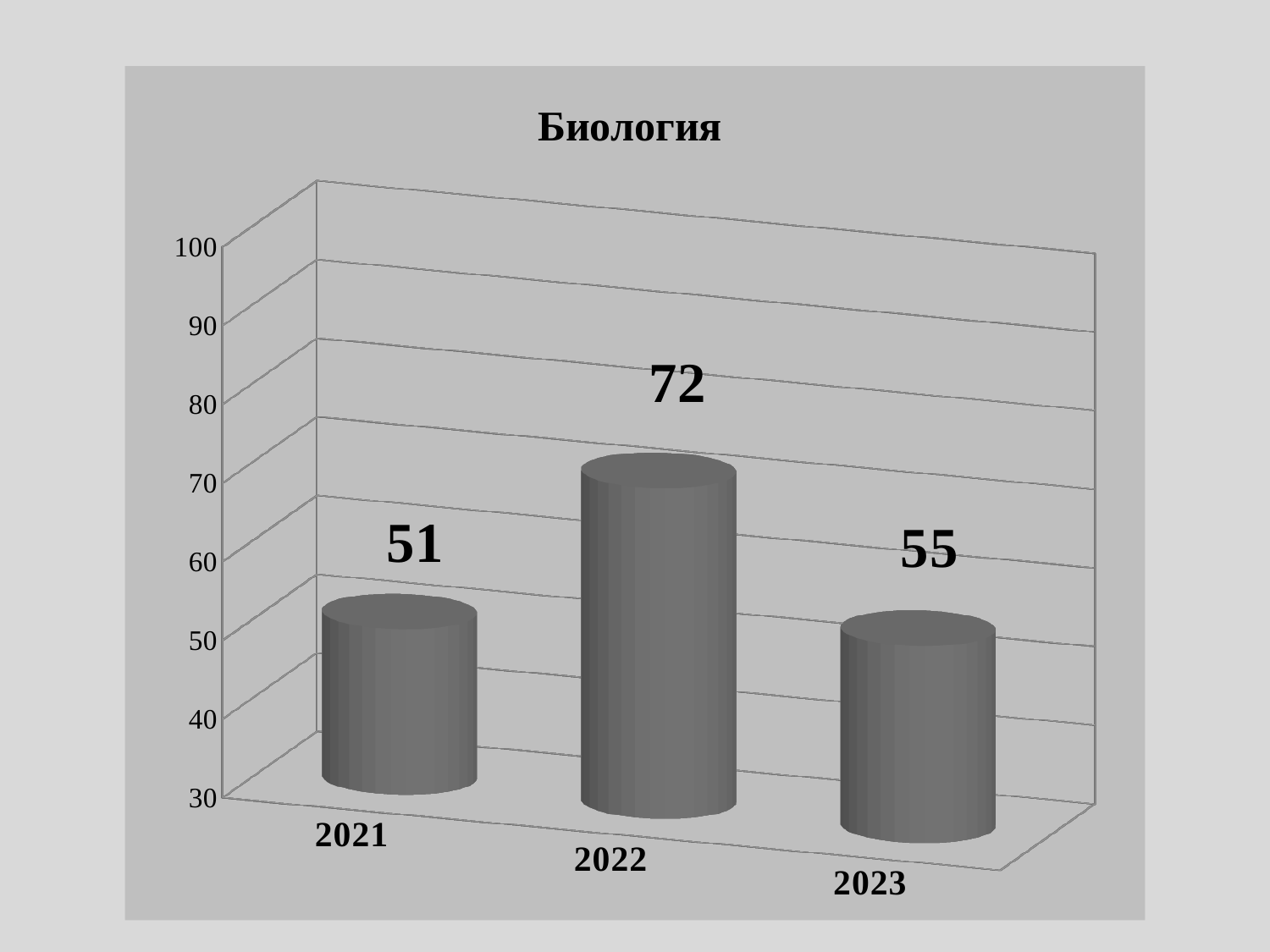
Which is larger, the value for 2022 or the value for 2023? 2022 How many years are shown on the chart? 3 What is the value for 2022? 72 What is the title of the chart? Биология Is the value for 2022 greater or less than 70? greater What is the value for 2021? 51 What is the value for 2023? 55 Which year has the lowest value? 2021 What is the difference between the values for 2022 and 2021? 21 What kind of chart is shown on the slide? bar chart Which year has the highest value? 2022 What is the difference between the values for 2023 and 2021? 4